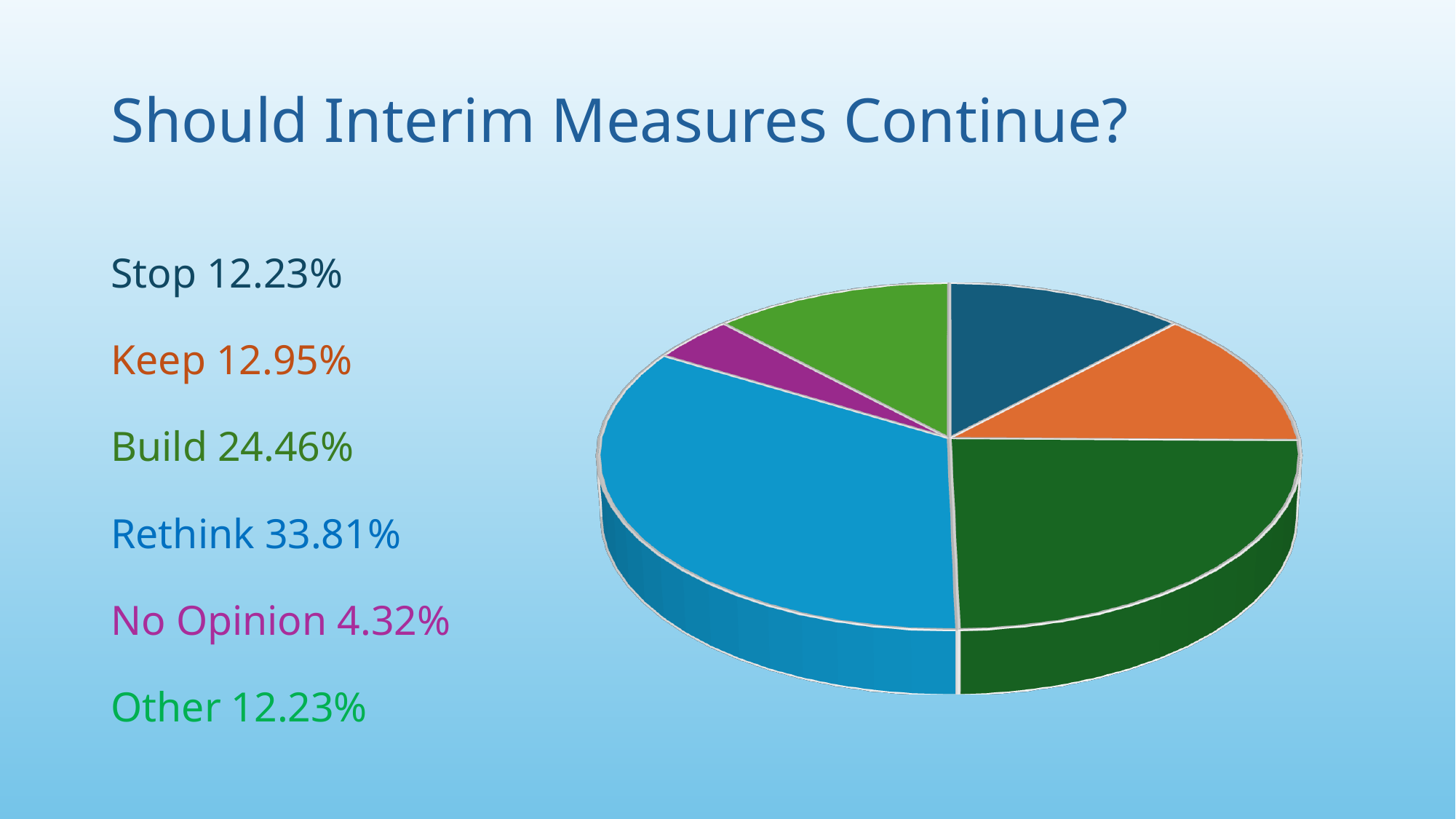
What is the combined percentage of Stop and Other? 24.46% Which category has the smallest share of the pie? No Opinion What percentage is shown for Rethink? 33.81% How many categories are listed for the pie chart? 6 What percentage is shown for No Opinion? 4.32% What is the title of the slide containing the pie chart? Should Interim Measures Continue? What is the difference between the Rethink and Build percentages? 9.35% What percentage is shown for Keep? 12.95% Which category has the largest share of the pie? Rethink What kind of chart is shown on the slide? pie chart Which is larger, the share for Build or the share for Keep? Build What percentage is shown for Build? 24.46%